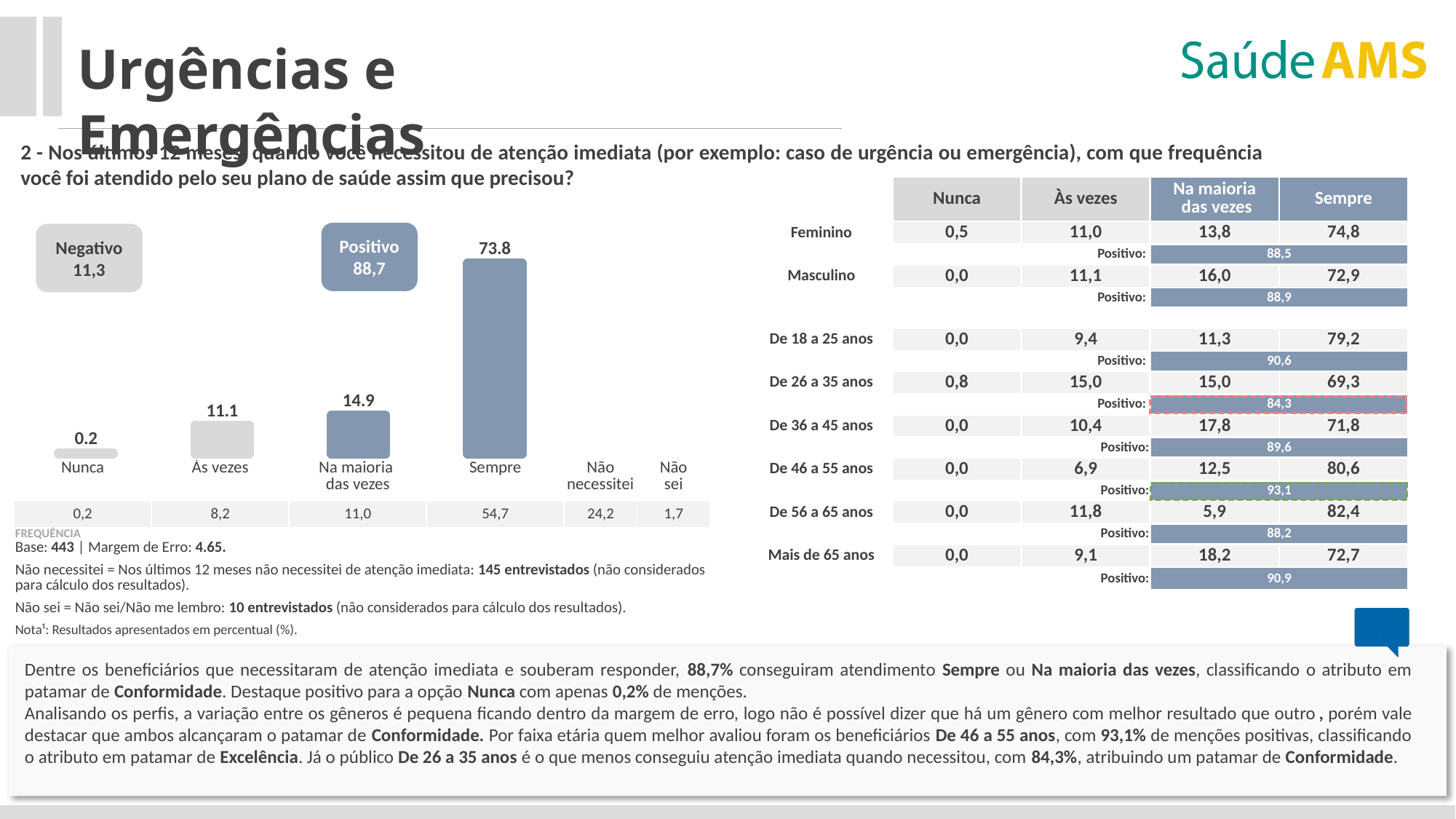
Which is larger, the Às vezes bar or the Na maioria das vezes bar? Na maioria das vezes What is the difference between the Sempre bar and the Na maioria das vezes bar? 58.9 Which category has the highest bar in the chart? Sempre What is the difference between the Na maioria das vezes bar and the Às vezes bar? 3.8 What is the value shown for the Nunca bar? 0.2 What kind of chart is shown on the slide? bar chart What is the value shown for the Às vezes bar? 11.1 Which category has the lowest bar in the chart? Nunca What is the value shown for the Sempre bar? 73.8 How many bars with data labels are plotted in the chart? 4 What is the value shown for the Na maioria das vezes bar? 14.9 What value is shown in the Positivo callout above the chart? 88,7